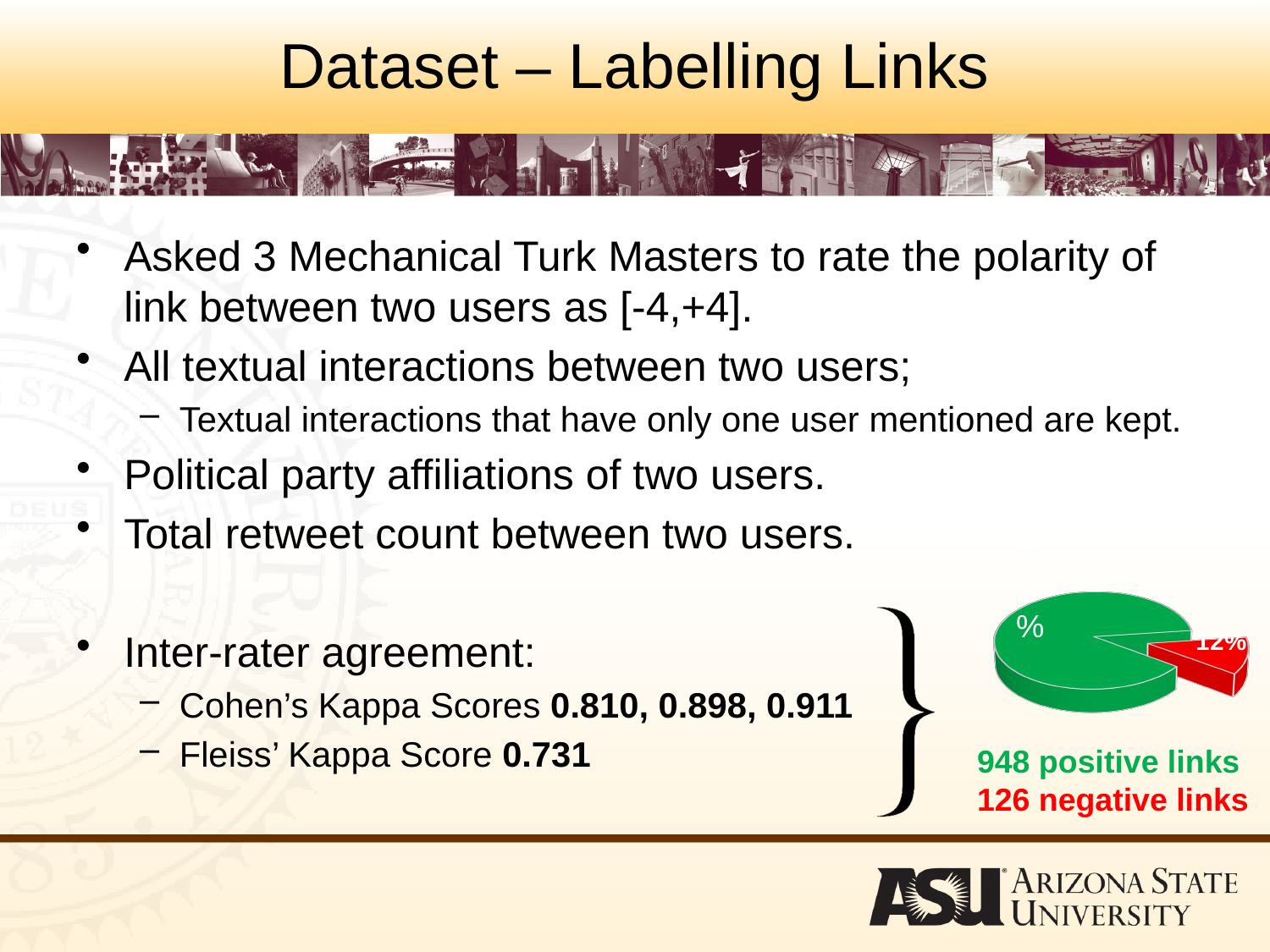
What colour is used for the positive links slice in the pie chart? Green What colour is used for the negative links slice in the pie chart? Red How many negative links are reported next to the pie chart? 126 What kind of chart is shown on the slide? Pie chart What is the difference between the number of positive links and the number of negative links? 822 How many slices does the pie chart have? 2 What percentage share does the red slice of the pie chart represent? 12% Which category has the largest slice in the pie chart? Positive links How many positive links are reported next to the pie chart? 948 Which category has the smallest slice in the pie chart? Negative links Which category makes up the larger slice of the pie chart, positive links or negative links? Positive links What is the total number of links represented in the pie chart (positive plus negative)? 1074